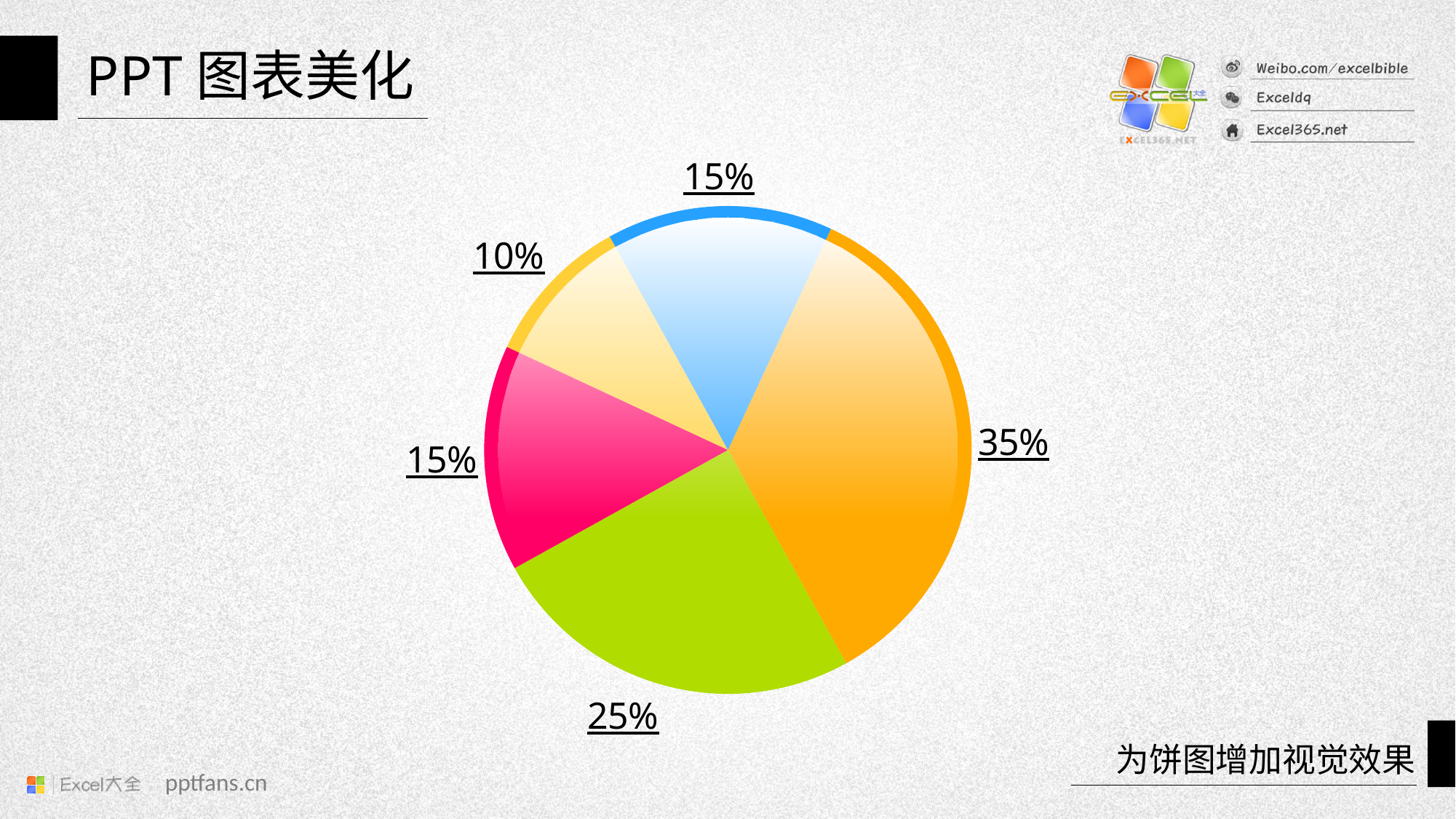
Which is larger, the green slice or the pink slice? the green slice How many slices does the pie chart have? 5 What kind of chart is shown on the slide? pie chart What percentage is shown for the pale yellow slice of the pie chart? 10% Which slice of the pie chart has the largest share? the orange slice (35%) What is the difference in percentage points between the orange slice and the green slice? 10 Which slice of the pie chart has the smallest share? the pale yellow slice (10%) What is the title of the slide containing the pie chart? PPT 图表美化 What percentage is shown for the orange slice of the pie chart? 35% What percentage is shown for the green slice of the pie chart? 25% What percentage is shown for the blue slice of the pie chart? 15% What percentage is shown for the pink slice of the pie chart? 15%